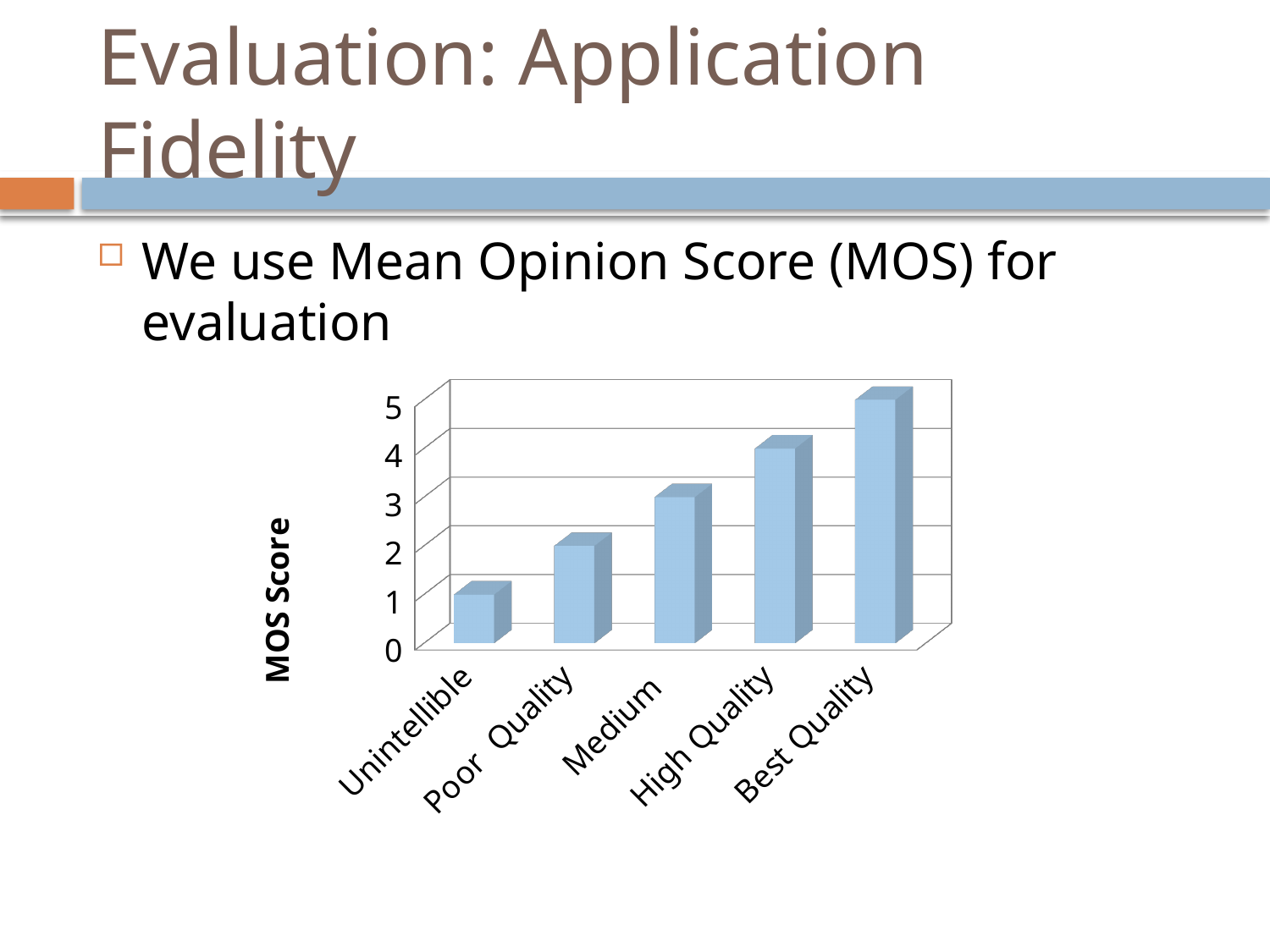
What is the difference between the MOS Score for Best Quality and the MOS Score for Poor Quality? 3 What is the MOS Score for Best Quality? 5 Which category has the lowest MOS Score? Unintellible What is the MOS Score for Unintellible? 1 What kind of chart is shown on the slide? bar chart Which has a higher MOS Score, Poor Quality or High Quality? High Quality Do the MOS Score values rise or fall from Unintellible to Best Quality? rise What is the MOS Score for Medium? 3 How many categories are shown on the x axis of the chart? 5 What is the label of the vertical axis of the chart? MOS Score Which category has the highest MOS Score? Best Quality Is the MOS Score for High Quality greater or less than 2? greater